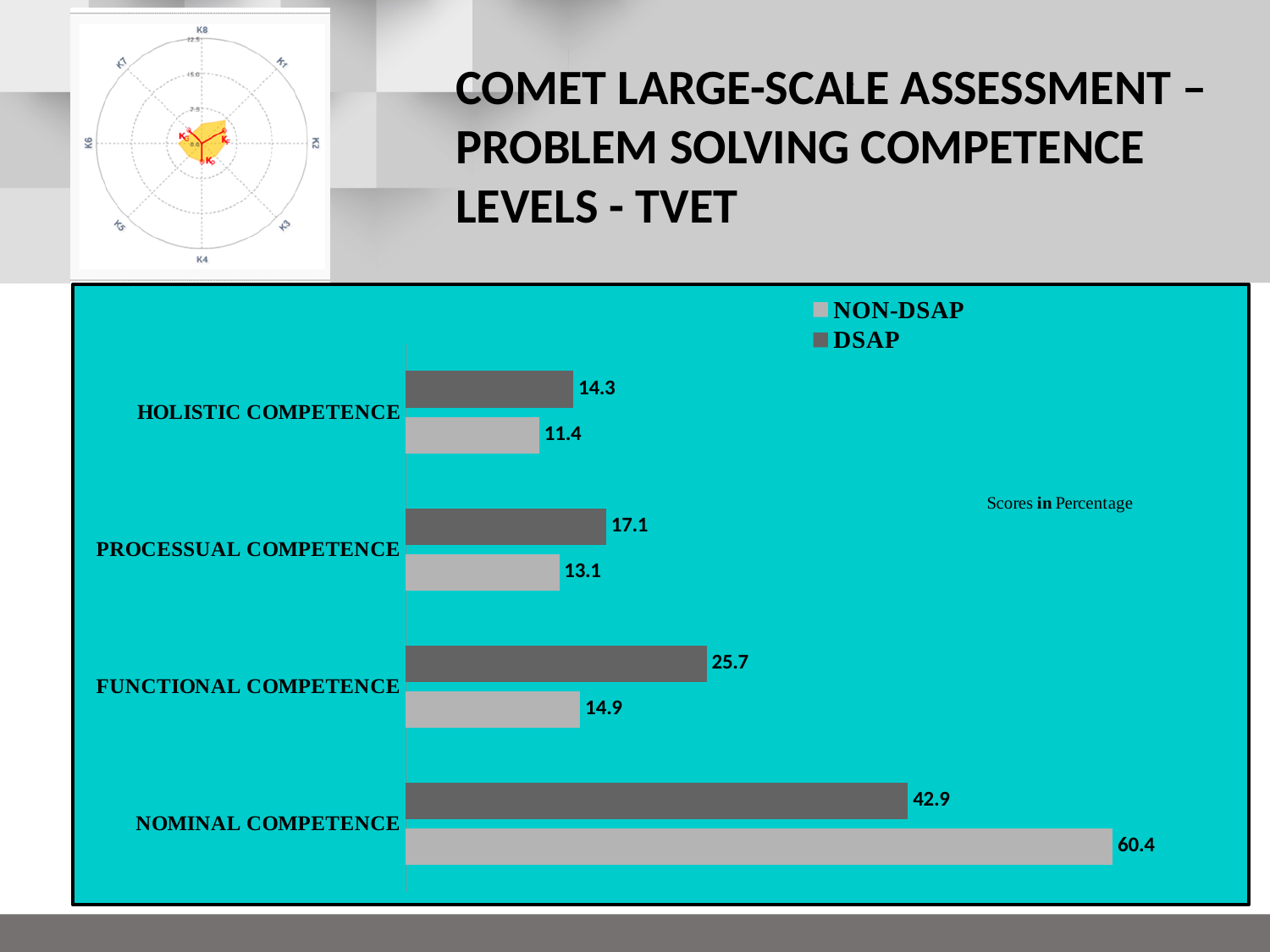
Which competence level has the highest DSAP score? Nominal Competence What is the DSAP score for Processual Competence? 17.1 What kind of chart is shown on the slide? Bar chart What is the DSAP score for Functional Competence? 25.7 What is the difference between the NON-DSAP and DSAP scores for Nominal Competence? 17.5 Which competence level has the lowest NON-DSAP score? Holistic Competence What is the difference between the DSAP and NON-DSAP scores for Functional Competence? 10.8 What is the NON-DSAP score for Nominal Competence? 60.4 What is the NON-DSAP score for Holistic Competence? 11.4 How many competence levels are shown on the chart? 4 For Processual Competence, which is larger, the DSAP score or the NON-DSAP score? DSAP How many series does the legend list? 2